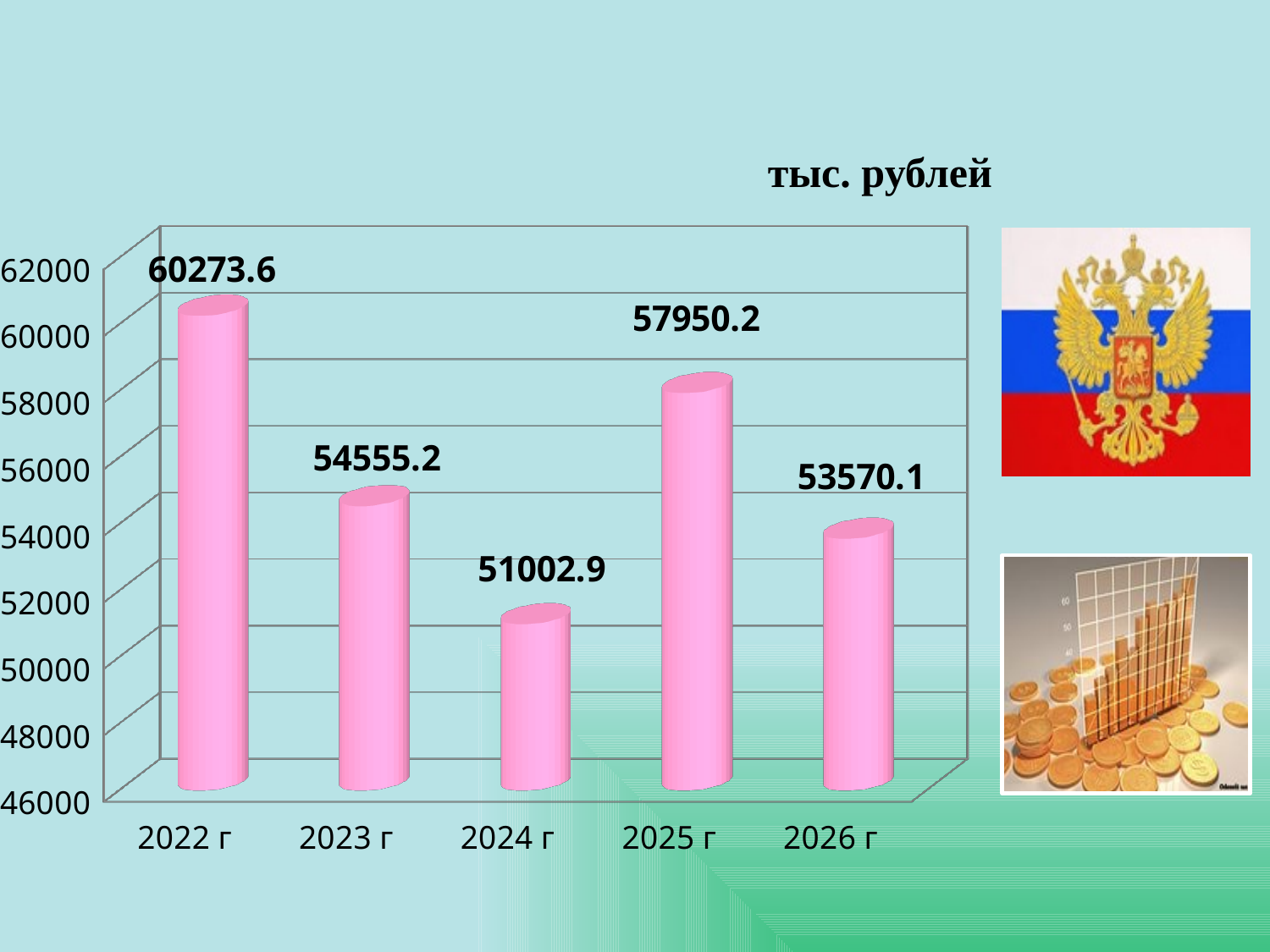
What is the value for 2022 г? 60273.6 Is the value for 2024 г greater or less than 52000? less Which is larger, the value for 2023 г or the value for 2025 г? 2025 г What kind of chart is shown on the slide? bar chart What unit is indicated above the chart? тыс. рублей What is the difference between the values for 2022 г and 2023 г? 5718.4 What is the difference between the values for 2025 г and 2026 г? 4380.1 What is the value for 2024 г? 51002.9 How many years are shown on the x axis? 5 Which year has the highest value? 2022 г What is the value for 2026 г? 53570.1 Which year has the lowest value? 2024 г